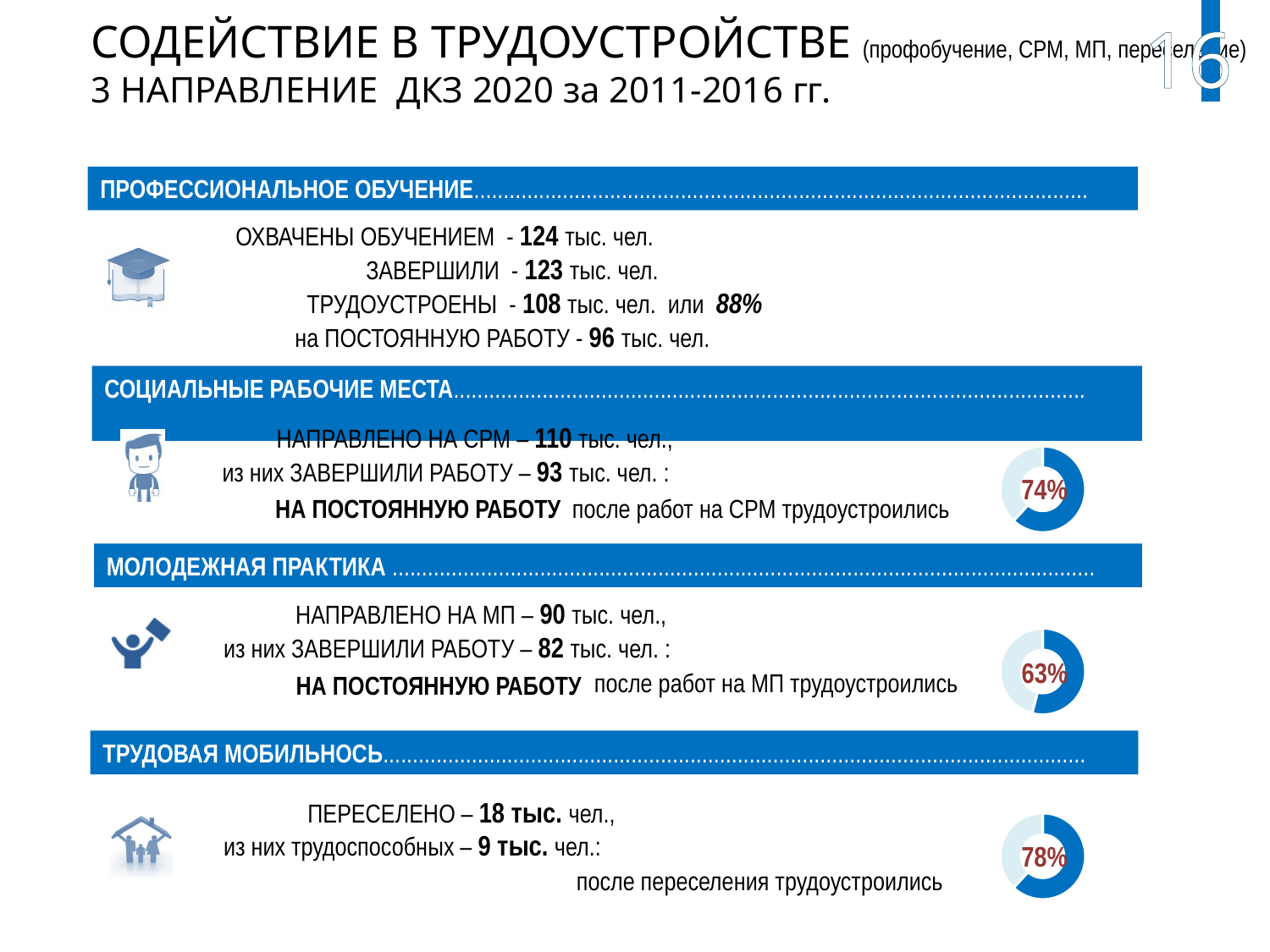
What is the difference between the percentages shown on the doughnut charts next to ТРУДОВАЯ МОБИЛЬНОСЬ and МОЛОДЕЖНАЯ ПРАКТИКА? 15 percentage points What value is shown on the doughnut chart next to the МОЛОДЕЖНАЯ ПРАКТИКА section? 63% What value is shown on the doughnut chart next to the СОЦИАЛЬНЫЕ РАБОЧИЕ МЕСТА section? 74% Which of the three doughnut charts on the slide shows the lowest percentage? The one next to МОЛОДЕЖНАЯ ПРАКТИКА (63%) What kind of chart is used next to each of the three lower sections of the slide? Doughnut (pie) chart Which is larger: the percentage on the doughnut chart next to СОЦИАЛЬНЫЕ РАБОЧИЕ МЕСТА or the one next to МОЛОДЕЖНАЯ ПРАКТИКА? СОЦИАЛЬНЫЕ РАБОЧИЕ МЕСТА (74%) What colour is the text of the percentage labels in the centre of the doughnut charts? Dark red How many doughnut charts are shown on the slide? 3 What value is shown on the doughnut chart next to the ТРУДОВАЯ МОБИЛЬНОСЬ section? 78% What is the difference between the percentages shown on the doughnut charts next to СОЦИАЛЬНЫЕ РАБОЧИЕ МЕСТА and МОЛОДЕЖНАЯ ПРАКТИКА? 11 percentage points Which of the three doughnut charts on the slide shows the highest percentage? The one next to ТРУДОВАЯ МОБИЛЬНОСЬ (78%)